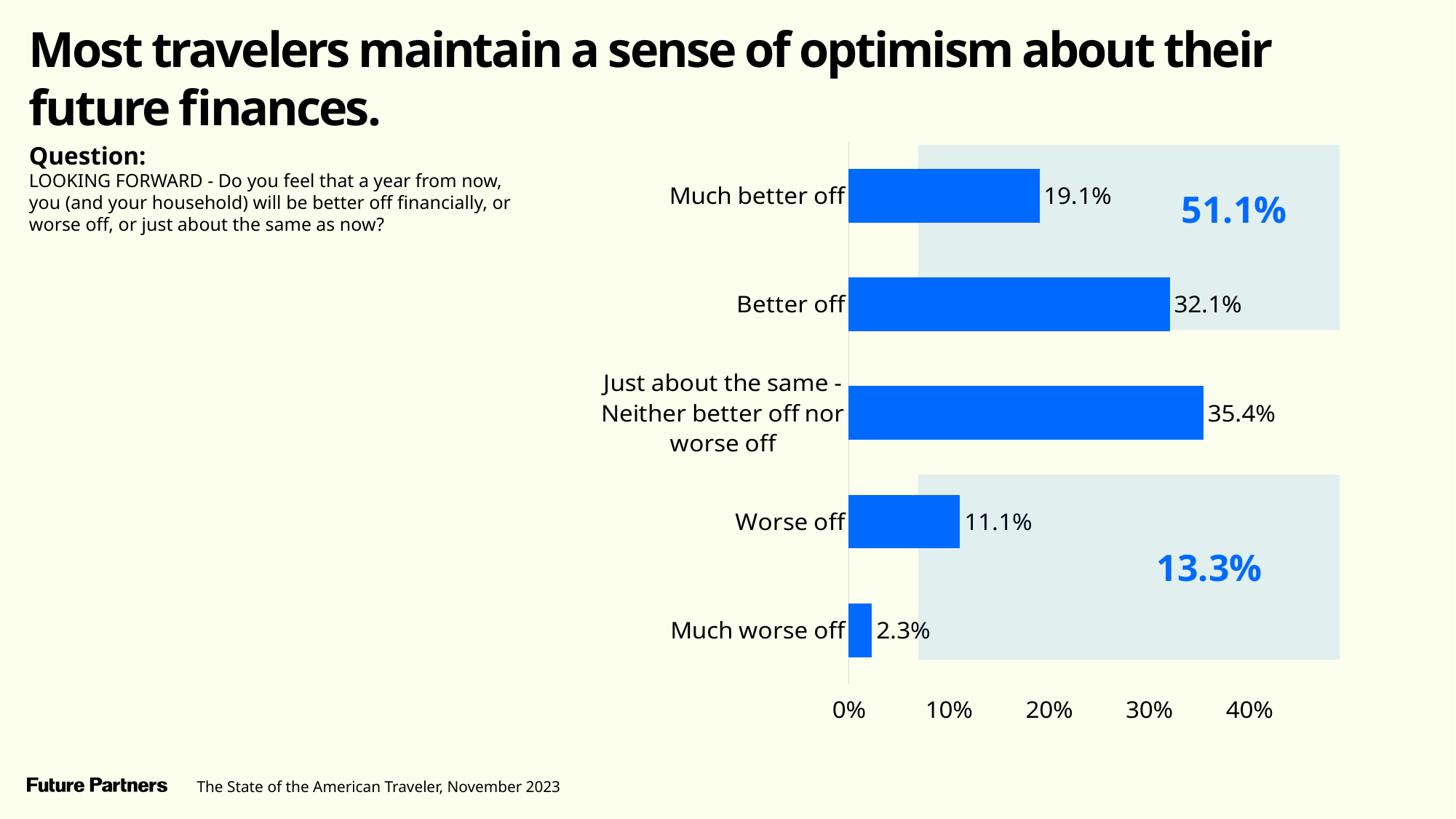
What combined percentage is shown for the "Worse off" and "Much worse off" responses? 13.3% What percentage of travelers said they expect to be "Better off"? 32.1% How many response categories are shown in the chart? 5 Which response category has the highest percentage? Just about the same - Neither better off nor worse off What percentage of travelers said they expect to be "Much better off" a year from now? 19.1% What is the difference in percentage points between "Better off" and "Much better off"? 13.0 percentage points Which is larger: the percentage for "Worse off" or for "Much better off"? Much better off What percentage of travelers said they expect to be "Much worse off"? 2.3% What percentage of travelers said "Just about the same - Neither better off nor worse off"? 35.4% What type of chart is shown on the slide? Bar chart Which response category has the lowest percentage? Much worse off What combined percentage is shown for the "Much better off" and "Better off" responses? 51.1%